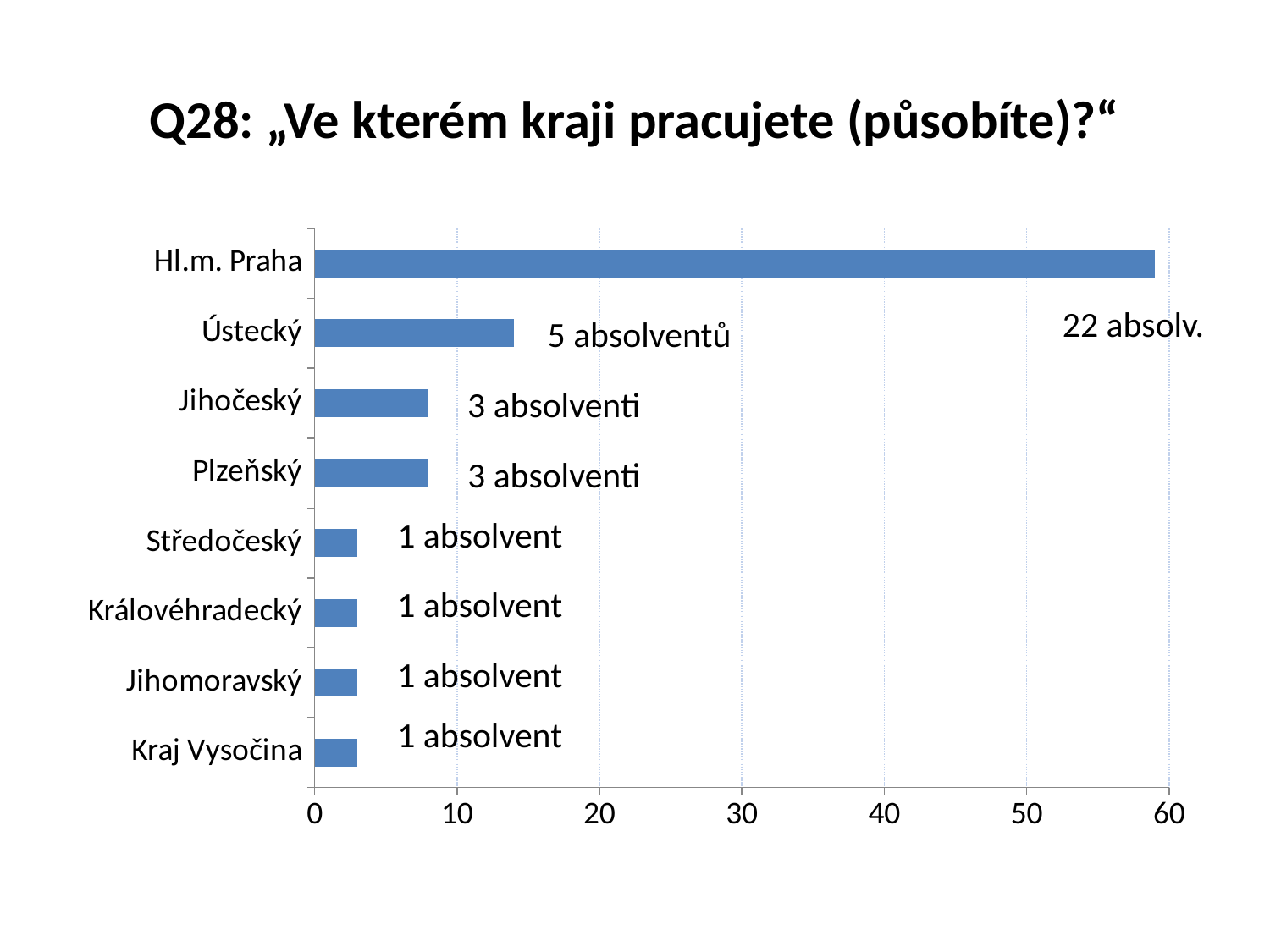
Which region has the longest bar in the chart? Hl.m. Praha What kind of chart is shown on the slide? bar chart According to the annotation next to the Ústecký bar, how many graduates does it represent? 5 absolventů Is the value for Jihočeský greater or less than 10? less Which has the larger value, Ústecký or Jihočeský? Ústecký Is the value for Ústecký greater or less than 10? greater What is the title of the chart on the slide? Q28: „Ve kterém kraji pracujete (působíte)?“ How many regions (categories) are shown in the chart? 8 According to the annotation next to the Plzeňský bar, how many graduates does it represent? 3 absolventi Which has the larger value, Hl.m. Praha or Ústecký? Hl.m. Praha Is the value for Středočeský greater or less than 10? less